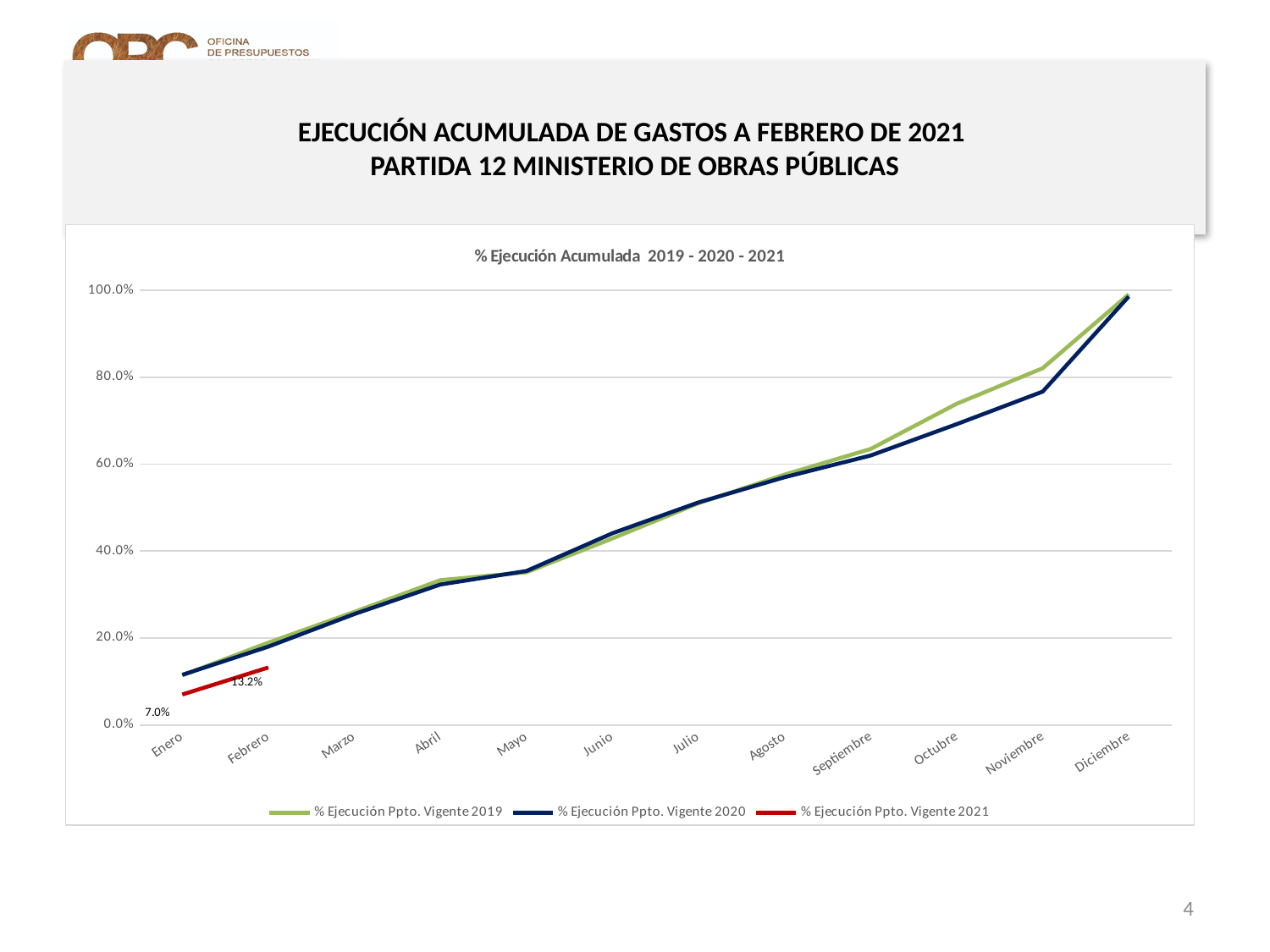
What kind of chart is shown on the slide? Line chart What is the value for Febrero in the % Ejecución Ppto. Vigente 2021 series? 13.2% Is the value for Noviembre in the % Ejecución Ppto. Vigente 2020 series greater or less than 80.0%? less What colour is the line for % Ejecución Ppto. Vigente 2021? Red At Noviembre, which series has the higher value: % Ejecución Ppto. Vigente 2019 or % Ejecución Ppto. Vigente 2020? % Ejecución Ppto. Vigente 2019 How many series does the legend list? 3 What is the value for Enero in the % Ejecución Ppto. Vigente 2021 series? 7.0% Is the value for Enero in the % Ejecución Ppto. Vigente 2020 series greater or less than 20.0%? less Do the values of the % Ejecución Ppto. Vigente 2020 series rise or fall from Enero to Diciembre? Rise How many months are shown on the x axis? 12 By how much did the % Ejecución Ppto. Vigente 2021 series increase from Enero to Febrero? 6.2% What is the title of the chart? % Ejecución Acumulada 2019 - 2020 - 2021